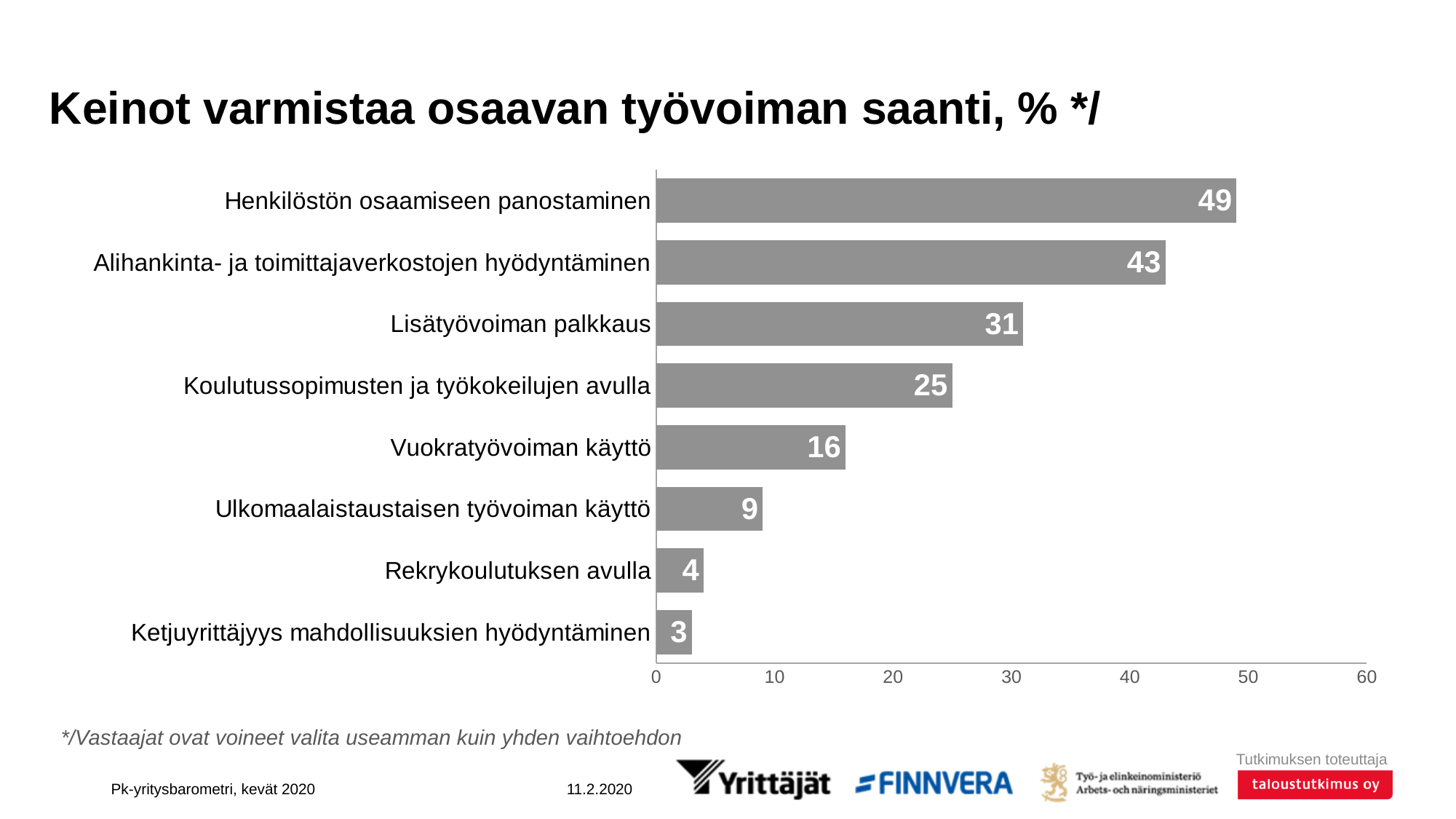
Is the value for Alihankinta- ja toimittajaverkostojen hyödyntäminen greater or less than 40? greater Which category has the highest value? Henkilöstön osaamiseen panostaminen What kind of chart is shown on the slide? bar chart Which category has the lowest value? Ketjuyrittäjyys mahdollisuuksien hyödyntäminen Which is larger: the value for Koulutussopimusten ja työkokeilujen avulla or the value for Ulkomaalaistaustaisen työvoiman käyttö? Koulutussopimusten ja työkokeilujen avulla What is the title of the chart? Keinot varmistaa osaavan työvoiman saanti, % */ What is the difference between the values for Henkilöstön osaamiseen panostaminen and Alihankinta- ja toimittajaverkostojen hyödyntäminen? 6 How many categories are shown in the chart? 8 What is the value for Rekrykoulutuksen avulla? 4 What is the value for Vuokratyövoiman käyttö? 16 What is the value for Henkilöstön osaamiseen panostaminen? 49 What is the value for Lisätyövoiman palkkaus? 31